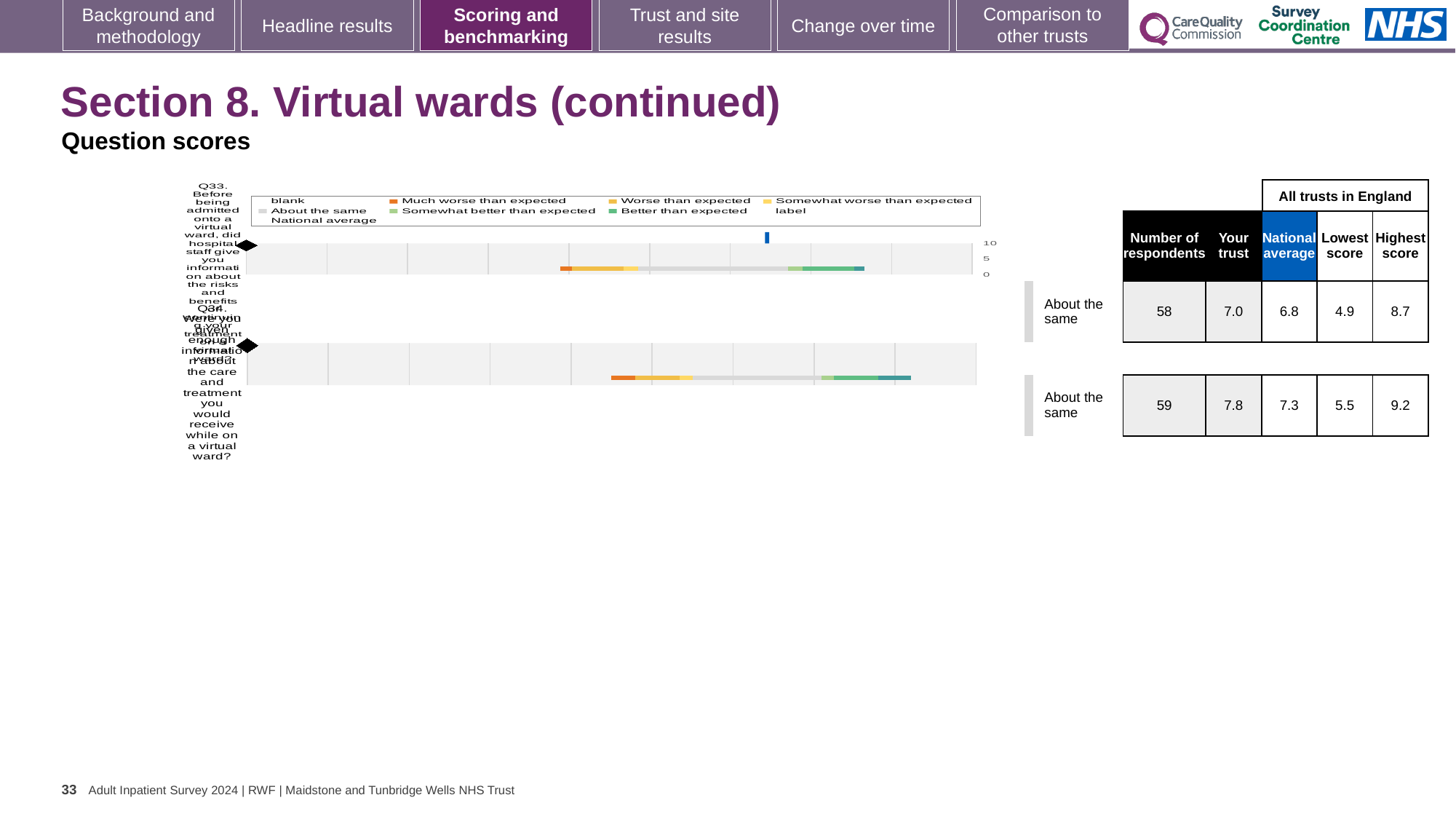
What is the difference between the highest and lowest scores for Q34? 3.7 What is the 'Your trust' score for Q33 in the table beside the chart? 7.0 What kind of chart is used to show the question scores for Q33 and Q34? bar chart What is the difference between the 'Your trust' score and the national average for Q33? 0.2 What is the highest score among all trusts in England for Q33? 8.7 How many respondents answered Q34 according to the table beside the chart? 59 Which question has the higher 'Your trust' score, Q33 or Q34? Q34 What benchmark category is shown for Q33 next to the chart? About the same How many questions (bars) are plotted in the chart? 2 Which legend entry is shown in orange? Much worse than expected What is the lowest score among all trusts in England for Q34? 5.5 What is the national average score for Q34 in the table beside the chart? 7.3